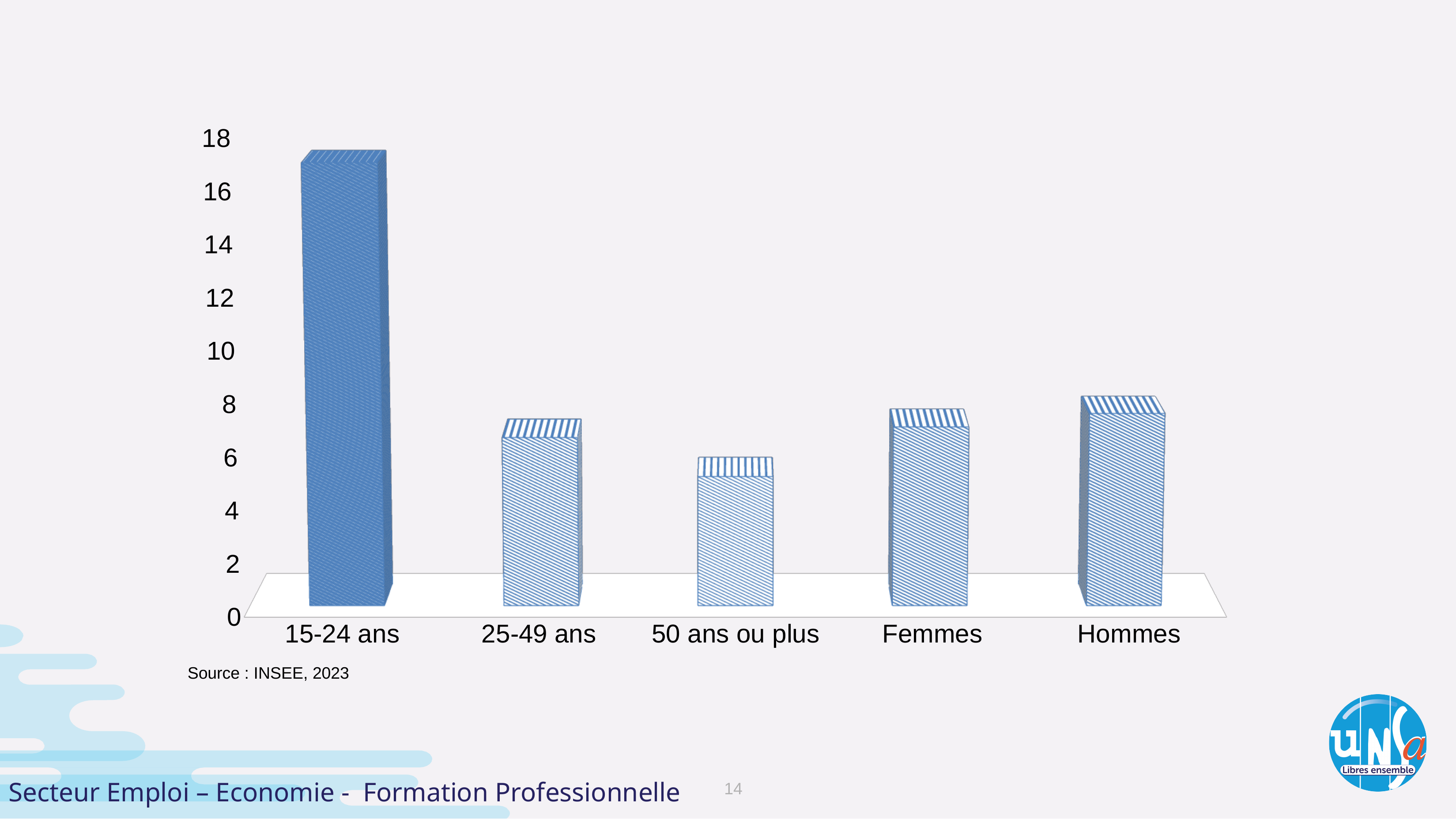
Which is larger, the value for 25-49 ans or the value for 50 ans ou plus? 25-49 ans Is the value for Femmes greater or less than 4? greater Is the value for 15-24 ans greater or less than 16? greater How many categories are shown on the x axis of the chart? 5 Which category has the highest bar in the chart? 15-24 ans What kind of chart is shown on the slide? bar chart Is the value for Hommes greater or less than 10? less Which is larger, the value for 15-24 ans or the value for Femmes? 15-24 ans What source is cited below the chart? INSEE, 2023 Which category has the lowest bar in the chart? 50 ans ou plus